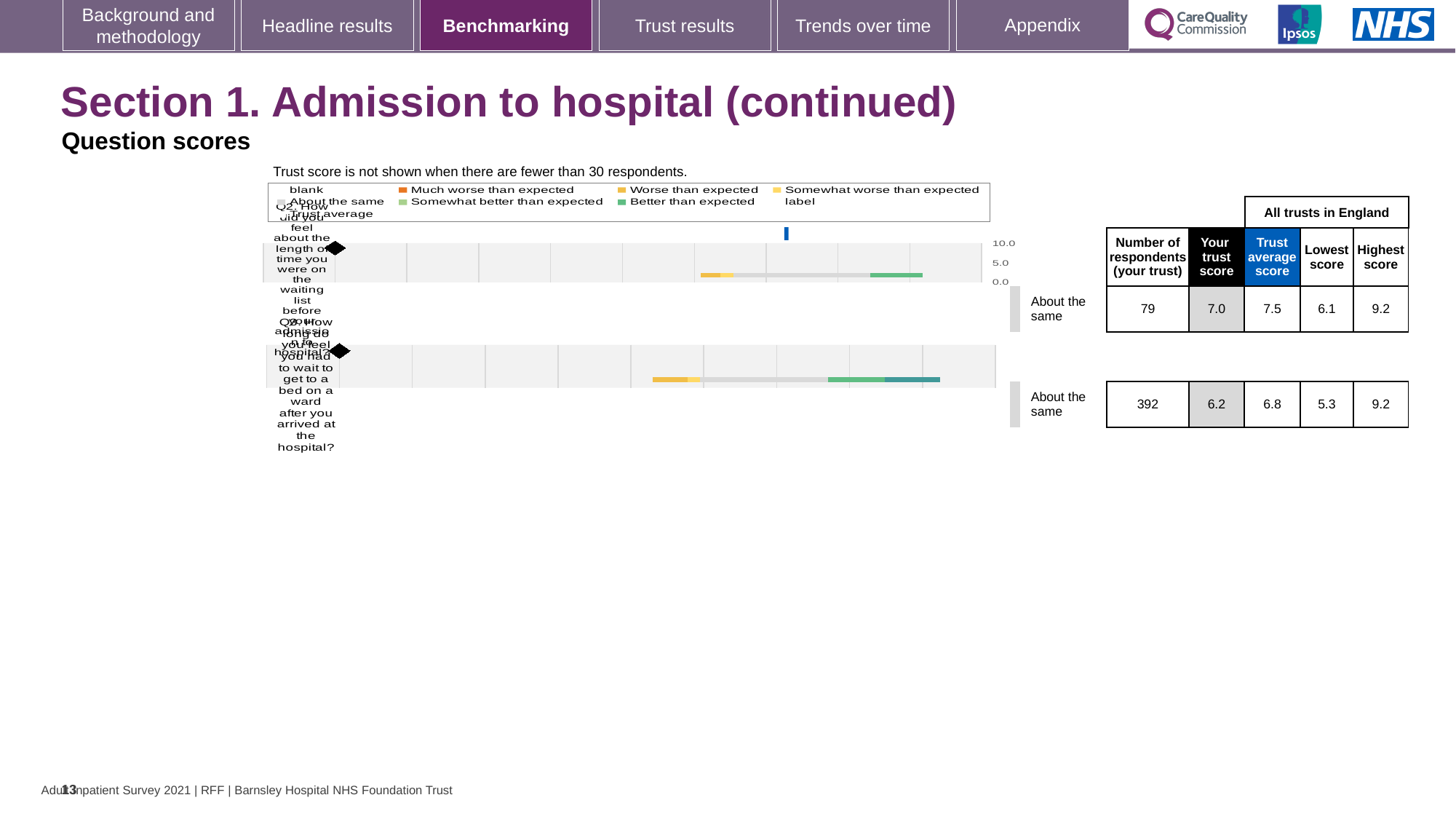
By how much is the trust average score higher than the trust score for Q3? 0.6 What is the trust score for Q2 (how did you feel about the length of time you were on the waiting list before admission)? 7.0 By how much is the trust average score higher than the trust score for Q2? 0.5 Is the trust score for Q3 greater or less than 5.0 on the chart axis? greater How many respondents from the trust answered Q3? 392 What is the lowest score across all trusts in England for Q3? 5.3 Which question has the higher trust score, Q2 or Q3? Q2 What is the trust score for Q3 (how long did you feel you had to wait to get to a bed on a ward after you arrived at the hospital)? 6.2 How many questions are plotted on this slide? 2 What is the trust average score across all trusts in England for Q2? 7.5 How many respondents from the trust answered Q2? 79 How is the trust's result for Q3 categorised relative to expectations? About the same